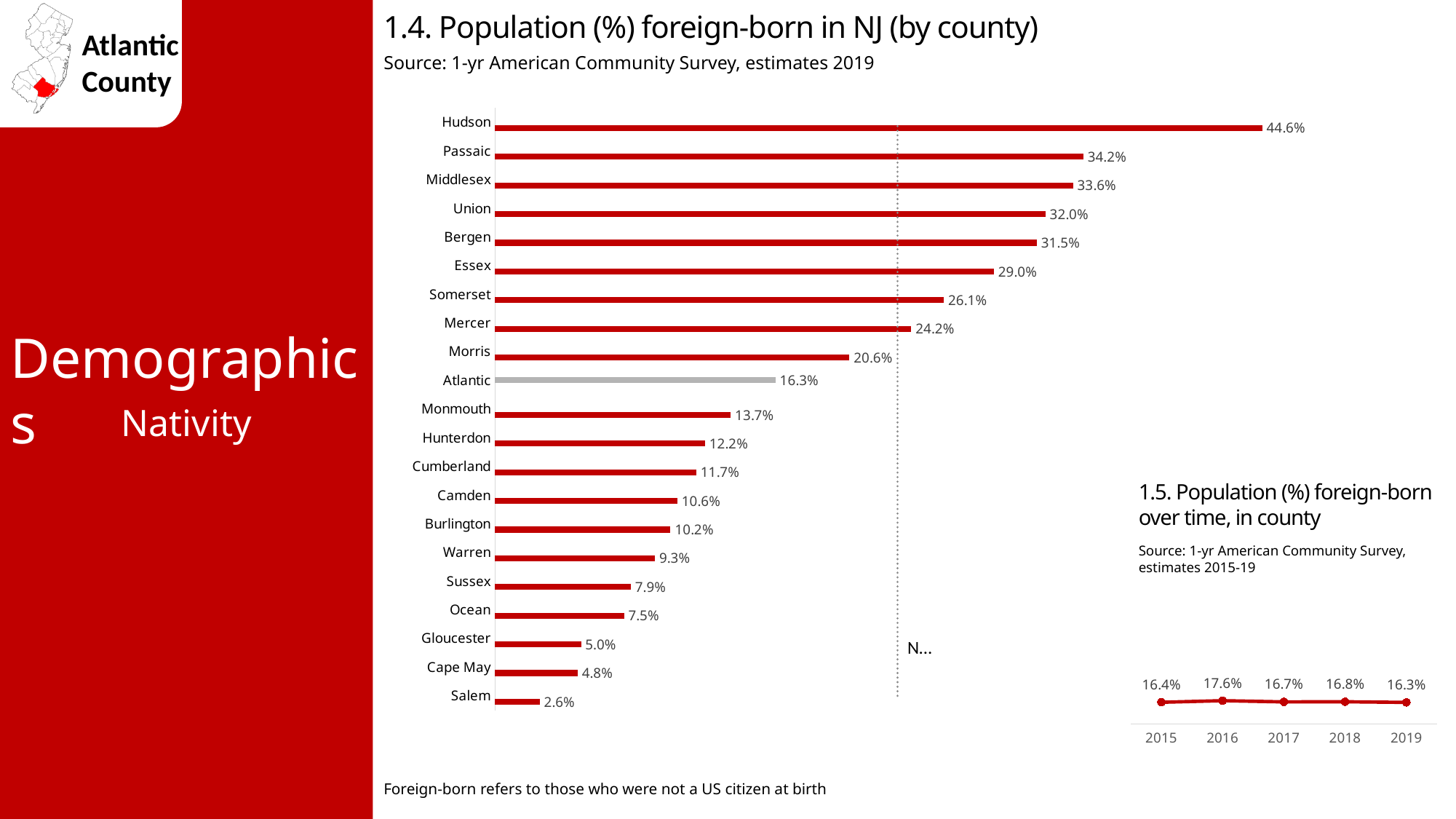
In the chart '1.4. Population (%) foreign-born in NJ (by county)', which county has the highest value? Hudson In the chart '1.4. Population (%) foreign-born in NJ (by county)', which is larger, Camden or Burlington? Camden In the chart '1.5. Population (%) foreign-born over time, in county', which year has the highest value? 2016 In the chart '1.4. Population (%) foreign-born in NJ (by county)', which county has the lowest value? Salem In the chart '1.4. Population (%) foreign-born in NJ (by county)', how many counties are shown? 21 In the chart '1.4. Population (%) foreign-born in NJ (by county)', what is the value for Atlantic? 16.3% In the chart '1.4. Population (%) foreign-born in NJ (by county)', what is the value for Mercer? 24.2% In the chart '1.4. Population (%) foreign-born in NJ (by county)', what is the difference between Hudson and Passaic? 10.4% In the chart '1.4. Population (%) foreign-born in NJ (by county)', which county's bar is shown in grey instead of red? Atlantic In the chart '1.5. Population (%) foreign-born over time, in county', how many years are plotted? 5 What kind of chart is '1.4. Population (%) foreign-born in NJ (by county)'? Bar chart In the chart '1.5. Population (%) foreign-born over time, in county', what is the value for 2016? 17.6%